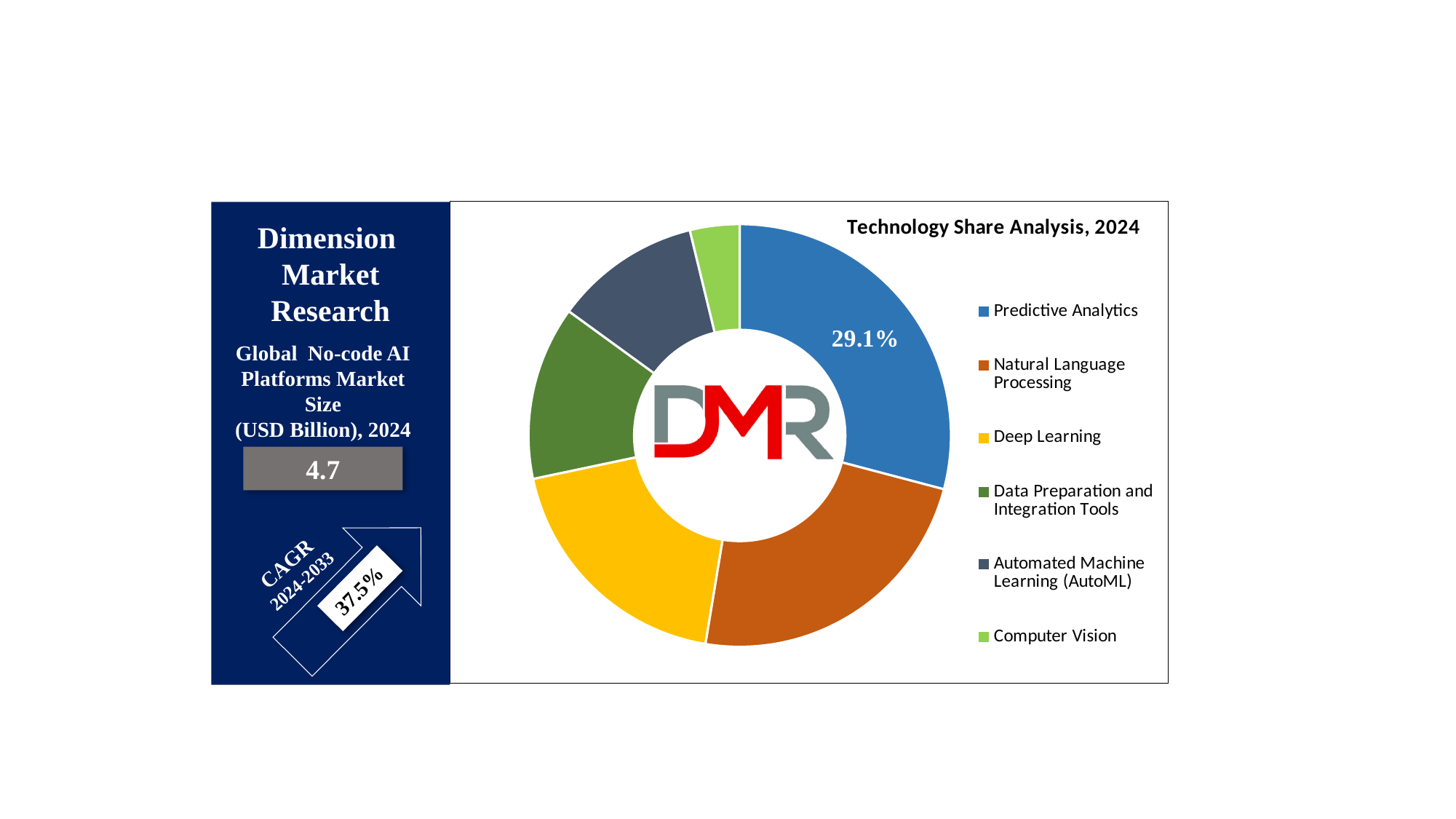
Which slice in the Technology Share Analysis, 2024 chart has a printed data label? Predictive Analytics What share of the pie does Predictive Analytics hold in the Technology Share Analysis, 2024 chart? 29.1% Which technology has the smallest slice in the Technology Share Analysis, 2024 chart? Computer Vision What kind of chart is the Technology Share Analysis, 2024 chart? Doughnut chart In the Technology Share Analysis, 2024 chart, which slice is larger: Natural Language Processing or Computer Vision? Natural Language Processing In the Technology Share Analysis, 2024 chart, which slice is larger: Deep Learning or Automated Machine Learning (AutoML)? Deep Learning How many technology categories are shown in the Technology Share Analysis, 2024 chart? 6 What colour represents Deep Learning in the Technology Share Analysis, 2024 chart? Yellow In the Technology Share Analysis, 2024 chart, which slice is larger: Predictive Analytics or Data Preparation and Integration Tools? Predictive Analytics How many entries does the legend of the Technology Share Analysis, 2024 chart list? 6 Which technology has the largest slice in the Technology Share Analysis, 2024 chart? Predictive Analytics What is the title of the pie chart on the slide? Technology Share Analysis, 2024